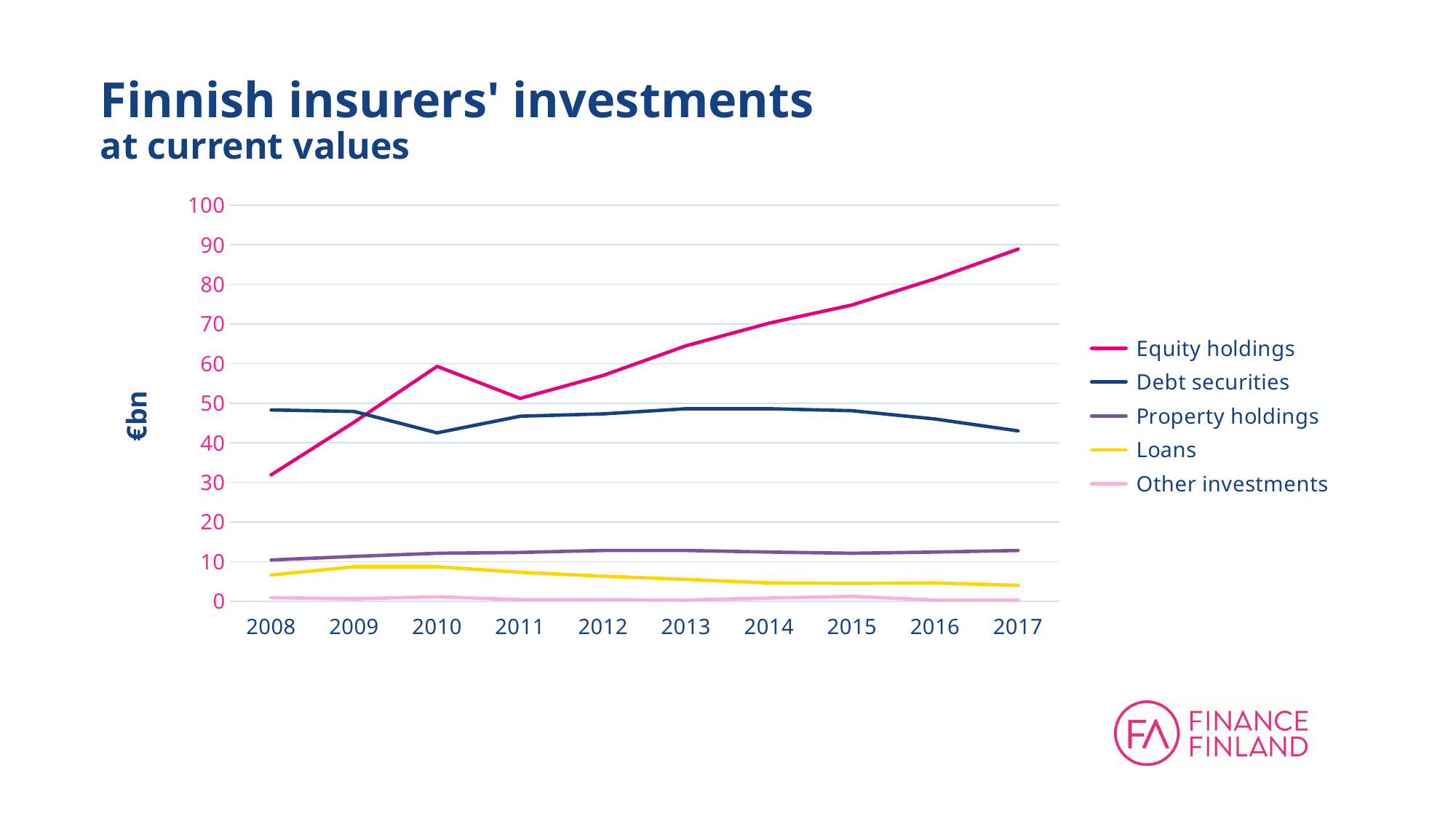
How many series does the legend list? 5 Which series has the highest value in 2017? Equity holdings How many years are shown on the x axis? 10 Is the value for Equity holdings in 2008 greater or less than 40? less Do the values for Equity holdings rise or fall from 2011 to 2017? rise In 2017, which is larger: Equity holdings or Debt securities? Equity holdings What kind of chart is shown on the slide? line chart Is the value for Equity holdings in 2017 greater or less than 80? greater Is the value for Debt securities in 2017 greater or less than 50? less What unit is shown on the y axis label? €bn In 2008, which is larger: Equity holdings or Debt securities? Debt securities Which series has the lowest values across all years? Other investments